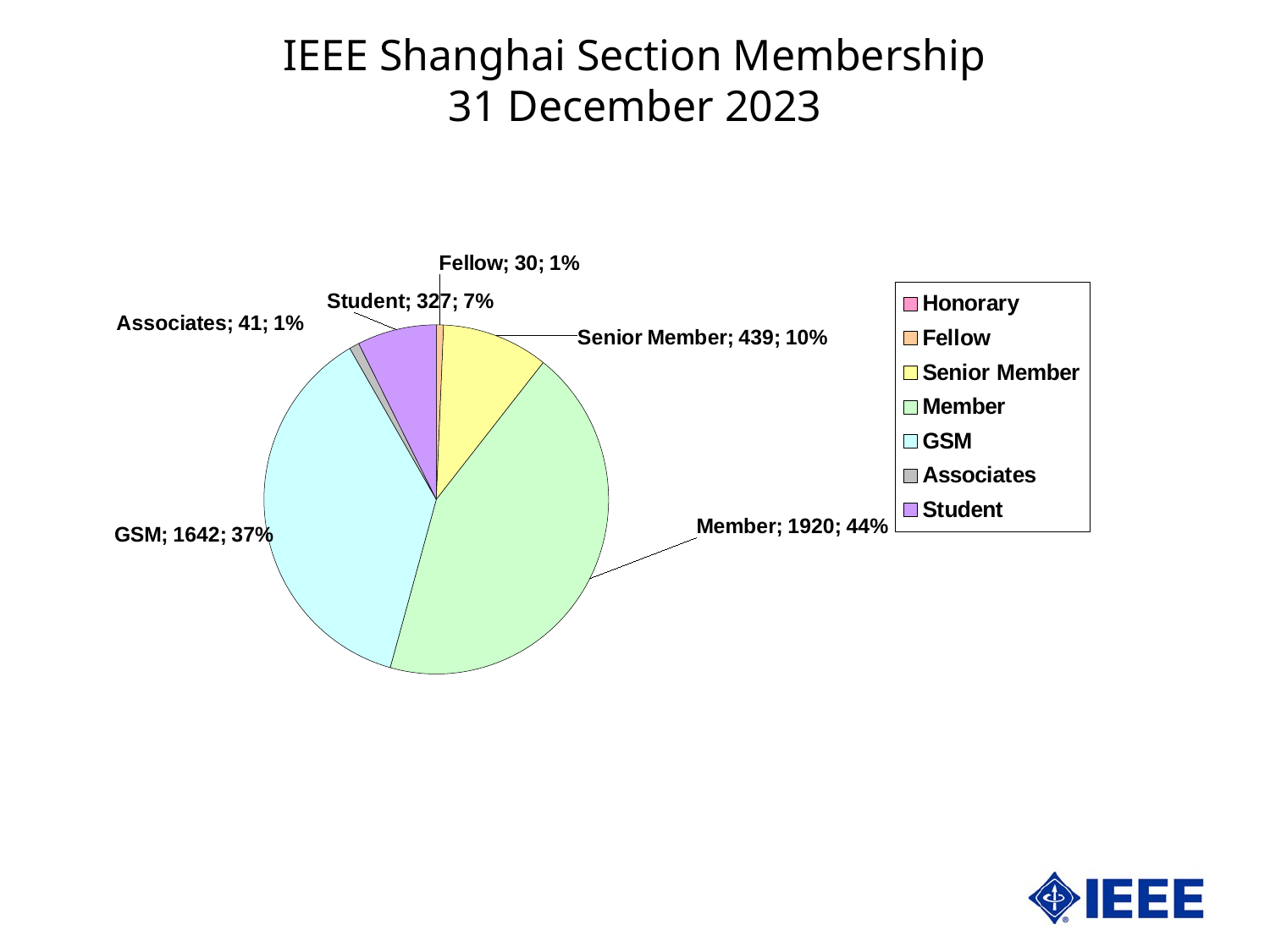
What type of chart is shown on the slide? pie chart What share of the pie does GSM represent? 37% What share of the pie does Student represent? 7% How many members are in the Member category? 1920 How many Senior Members are shown? 439 Which category has the largest slice of the pie? Member What is the difference between the Member value and the GSM value? 278 What is the value shown for GSM? 1642 Which is larger, Senior Member or Student? Senior Member What is the value shown for Associates? 41 How many categories does the legend list? 7 What is the value shown for Fellow? 30